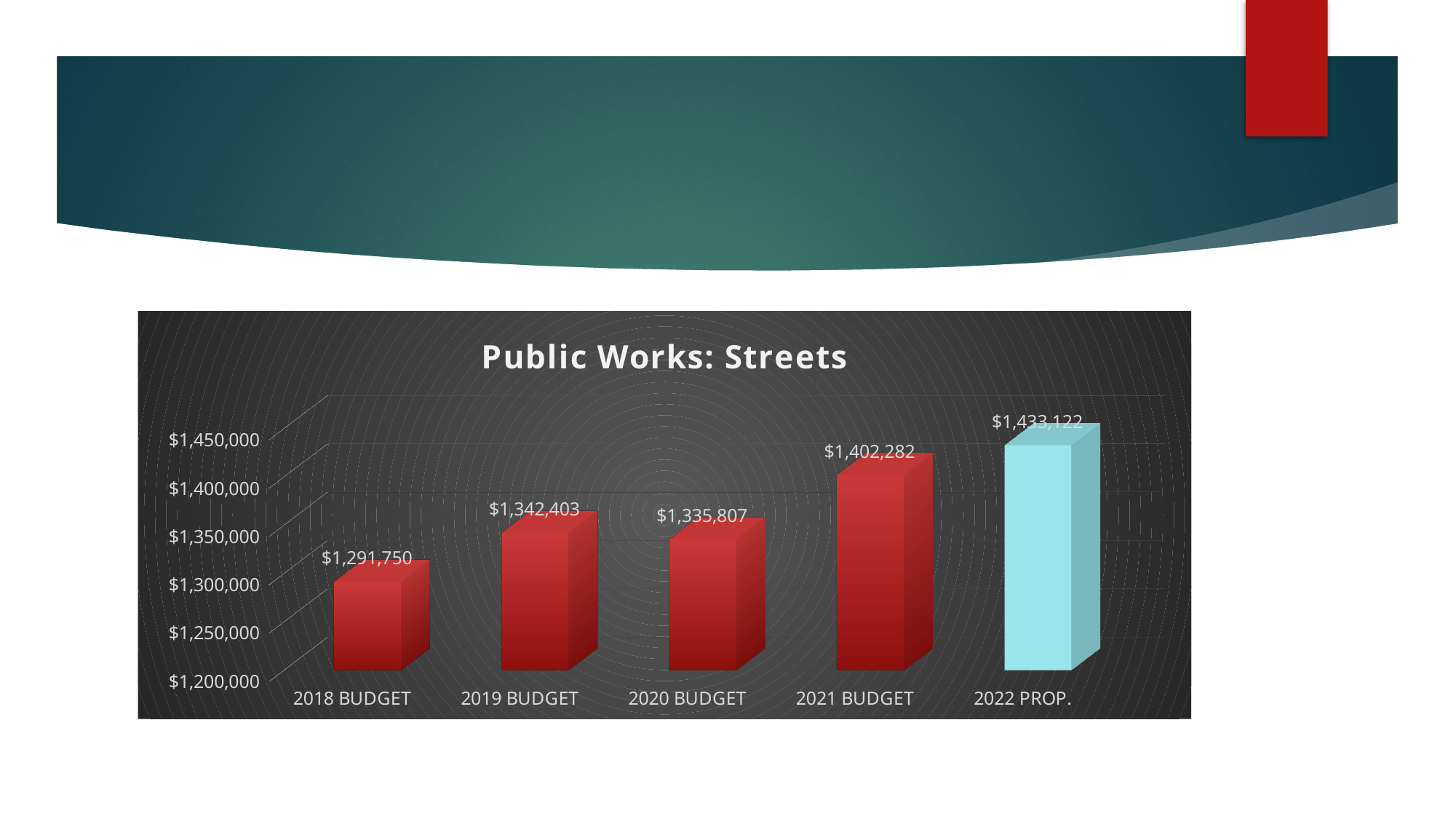
What is the value for 2022 PROP. in the Public Works: Streets chart? $1,433,122 What is the difference between the 2019 BUDGET value and the 2020 BUDGET value? $6,596 What kind of chart is shown on the slide? bar chart How many categories are shown in the Public Works: Streets chart? 5 Which category has the lowest value in the Public Works: Streets chart? 2018 BUDGET What is the value for 2020 BUDGET in the Public Works: Streets chart? $1,335,807 What is the value for 2018 BUDGET in the Public Works: Streets chart? $1,291,750 Do the values generally rise or fall from 2018 BUDGET to 2022 PROP.? rise Which category has the highest value in the Public Works: Streets chart? 2022 PROP. Which is larger, the value for 2019 BUDGET or the value for 2020 BUDGET? 2019 BUDGET What is the difference between the 2022 PROP. value and the 2021 BUDGET value? $30,840 Is the value for 2021 BUDGET greater or less than $1,400,000? greater